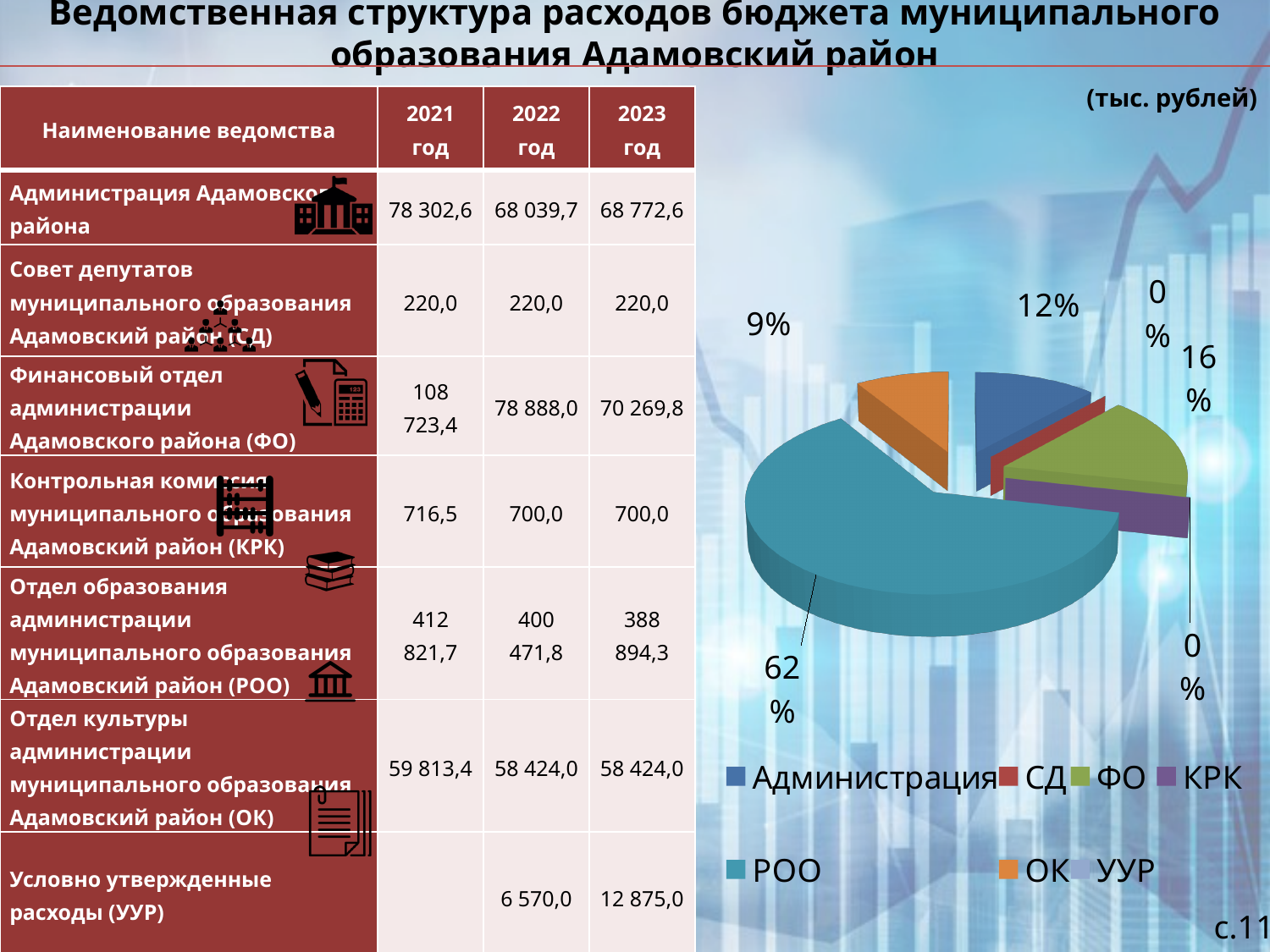
In the pie chart, what share is shown for Администрация? 12% In the pie chart, what is the difference between the share for РОО and the share for ФО? 46% What kind of chart is shown on the slide? pie chart What unit is indicated above the pie chart? тыс. рублей In the pie chart, what share is shown for ОК? 9% Which category has the largest slice in the pie chart? РОО In the pie chart, what is the difference between the share for Администрация and the share for ОК? 3% In the pie chart, what share is shown for РОО? 62% In the pie chart, what share is shown for ФО? 16% What colour is the РОО slice in the pie chart? teal In the pie chart, which is larger, the share for ФО or the share for Администрация? ФО How many entries does the pie chart legend list? 7